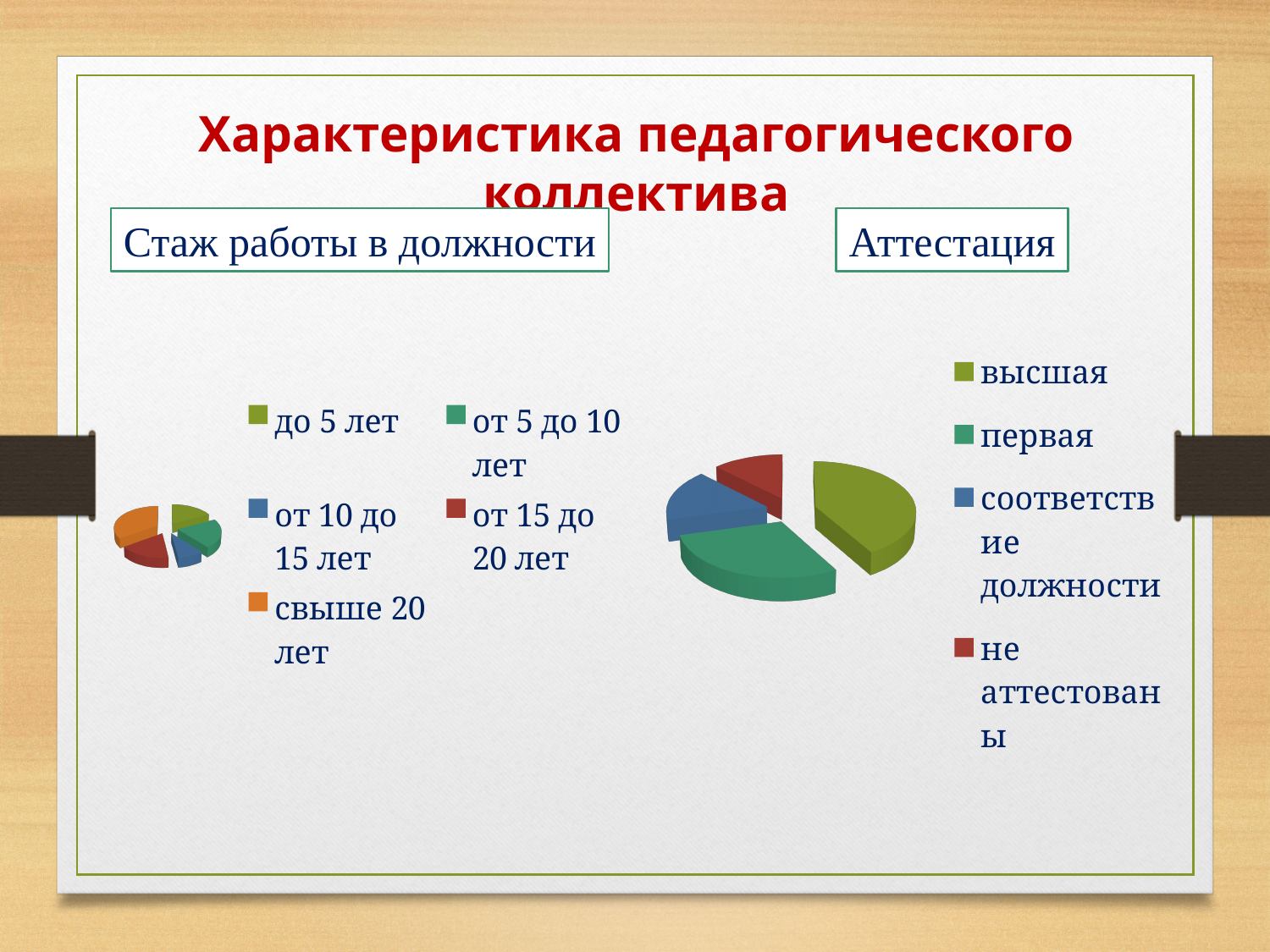
In the "Аттестация" chart, how many categories does the legend list? 4 In the "Стаж работы в должности" chart, how many categories does the legend list? 5 In the "Аттестация" chart, which legend entry is shown in blue? соответствие должности What kind of chart is the chart under the heading "Аттестация"? pie chart In the "Аттестация" chart, which category has the largest slice? высшая In the "Аттестация" chart, which slice is larger: "высшая" or "соответствие должности"? высшая In the "Стаж работы в должности" chart, which legend entry is shown in orange? свыше 20 лет In the "Аттестация" chart, which slice is larger: "первая" or "не аттестованы"? первая What kind of chart is the chart under the heading "Стаж работы в должности"? pie chart In the "Аттестация" chart, which category has the smallest slice? не аттестованы